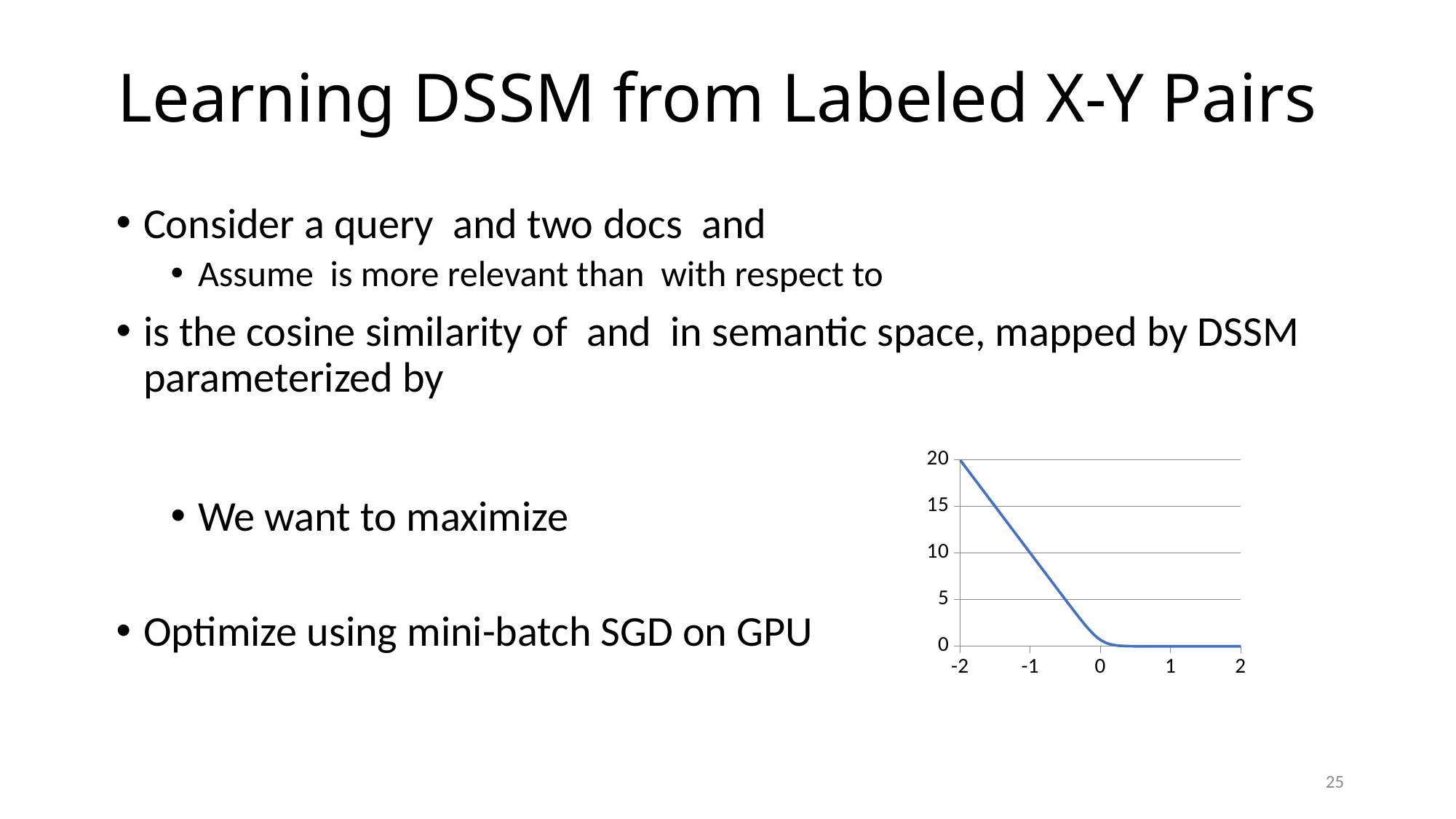
Is the value of the line at x = -2 greater or less than 15? greater What is the highest value labeled on the y axis of the chart? 20 Is the value of the line at x = 1 greater or less than 5? less What range of x values does the chart's x axis cover? -2 to 2 At which x value does the line reach its highest point? -2 Which is larger, the value of the line at x = -2 or at x = 1? x = -2 How many tick labels are shown on the x axis of the chart? 5 What kind of chart is shown on the slide? line chart Is the value of the line at x = 0 greater or less than 5? less Do the values on the chart rise or fall as x increases from -2 to 0? fall